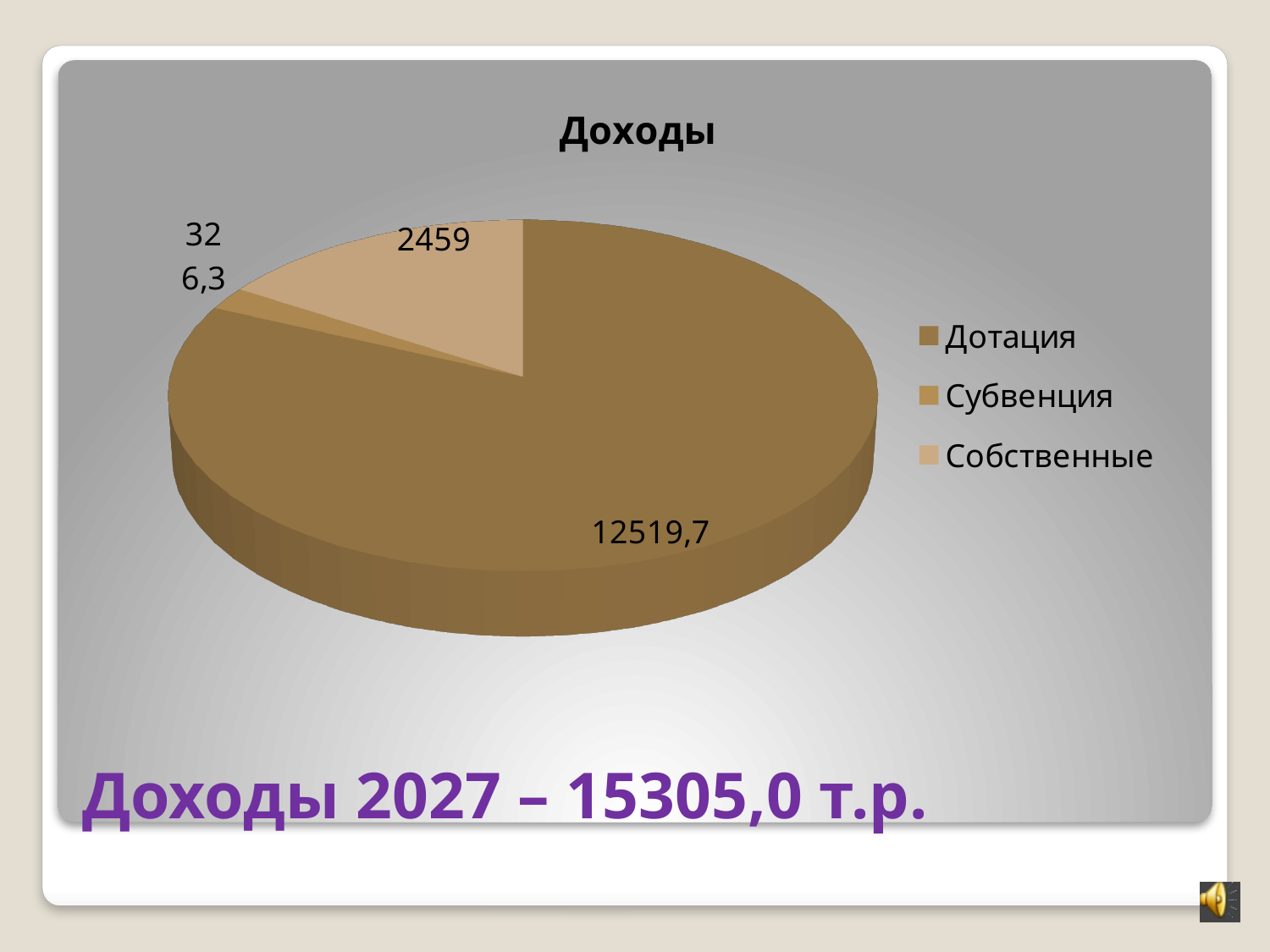
What is the value for Дотация in the pie chart? 12519,7 According to the caption below the chart, what is the total income (Доходы) for 2027? 15305,0 т.р. Which is larger, Дотация or Собственные? Дотация Which is larger, Собственные or Субвенция? Собственные What is the title of the chart? Доходы Which category has the smallest slice of the pie? Субвенция How many slices does the pie chart have? 3 What is the value for Собственные in the pie chart? 2459 How many entries does the legend list? 3 What kind of chart is shown on the slide? pie chart What is the difference between the values for Дотация and Собственные? 10060,7 Which category has the largest slice of the pie? Дотация